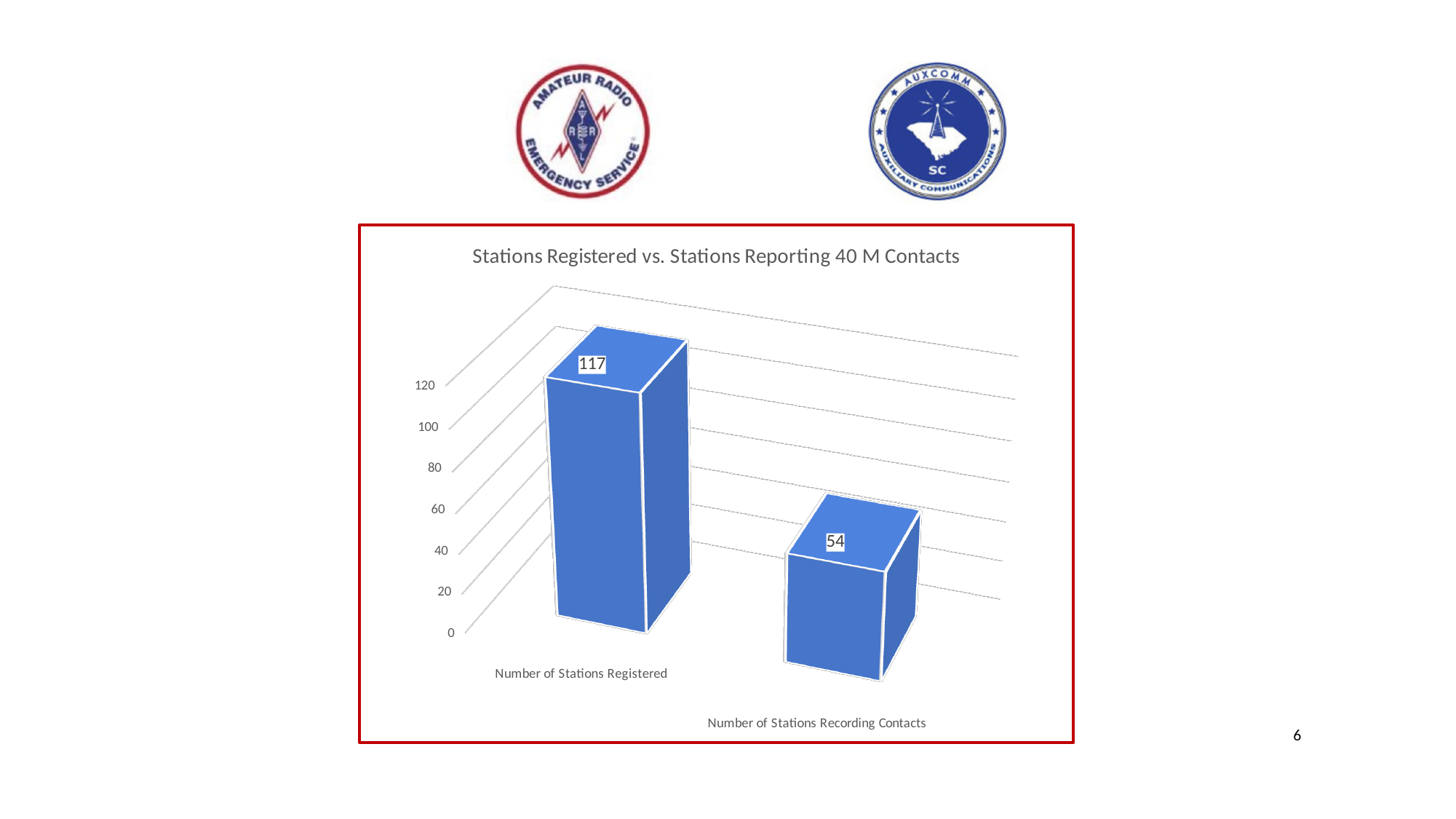
What is the highest value labelled on the vertical axis? 120 What is the title of the chart? Stations Registered vs. Stations Reporting 40 M Contacts What kind of chart is shown on the slide? Bar chart What is the value for Number of Stations Registered? 117 Is the value for Number of Stations Recording Contacts greater or less than 60? less How many categories are shown in the chart? 2 What is the value for Number of Stations Recording Contacts? 54 Which category has the highest value? Number of Stations Registered What is the difference between Number of Stations Registered and Number of Stations Recording Contacts? 63 Which category has the lowest value? Number of Stations Recording Contacts Which is larger, Number of Stations Registered or Number of Stations Recording Contacts? Number of Stations Registered Is the value for Number of Stations Registered greater or less than 100? greater